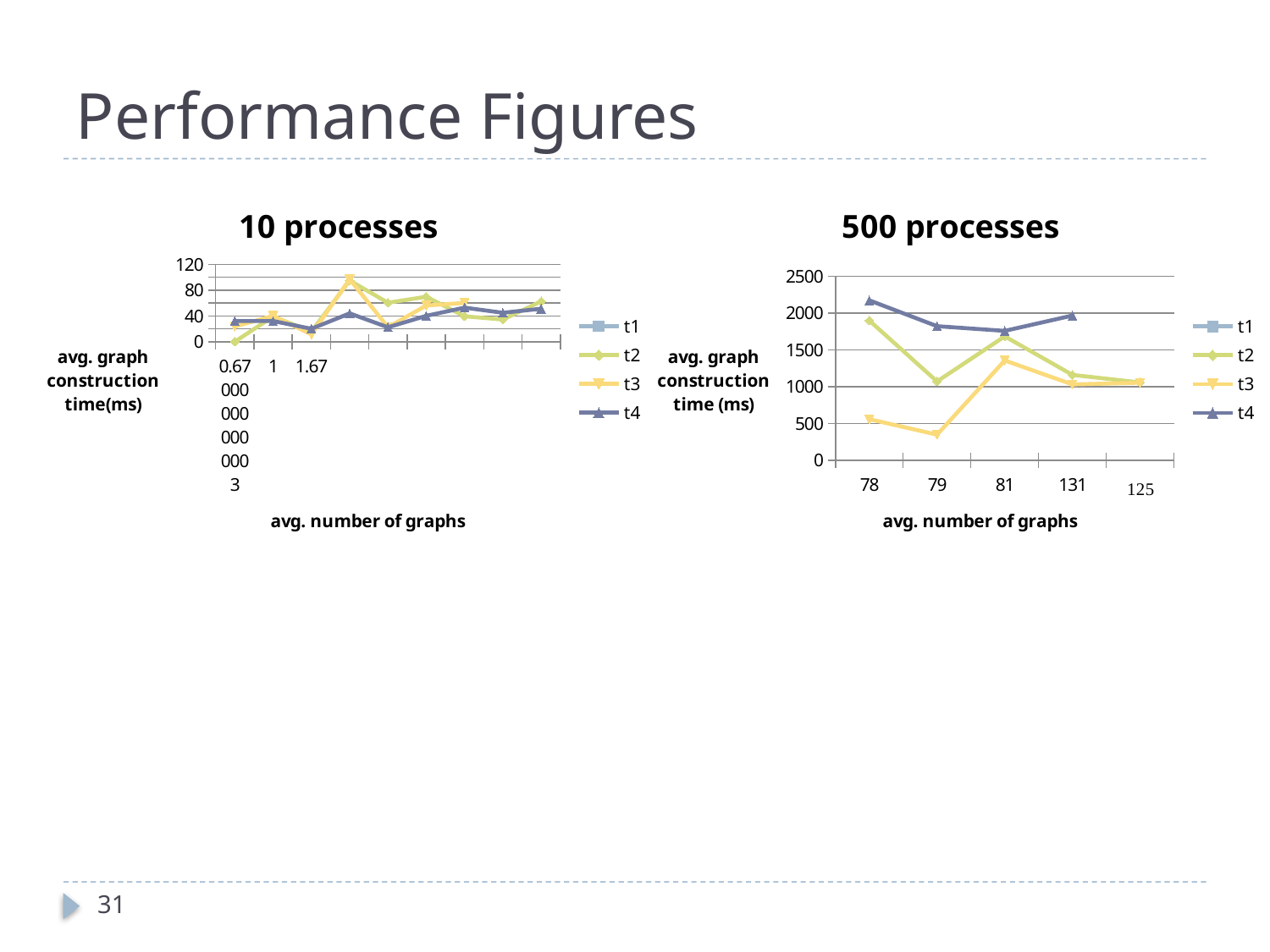
In the "500 processes" chart, is the value of t2 at 78 greater or less than 1500? greater What is the x-axis title of the "500 processes" chart? avg. number of graphs How many categories are shown on the x axis of the "500 processes" chart? 5 In the "500 processes" chart, is the value of t3 at 79 greater or less than 500? less How many series does the legend of the "10 processes" chart list? 4 In the "500 processes" chart, which is larger at 78: t3 or t4? t4 In the "500 processes" chart, does the t2 line rise or fall from 78 to 79? fall What kind of chart is the "500 processes" chart? line chart In the "500 processes" chart, which series has the lowest value at 79? t3 In the "500 processes" chart, is the value of t4 at 78 greater or less than 2000? greater In the "500 processes" chart, which series has the highest value at 78? t4